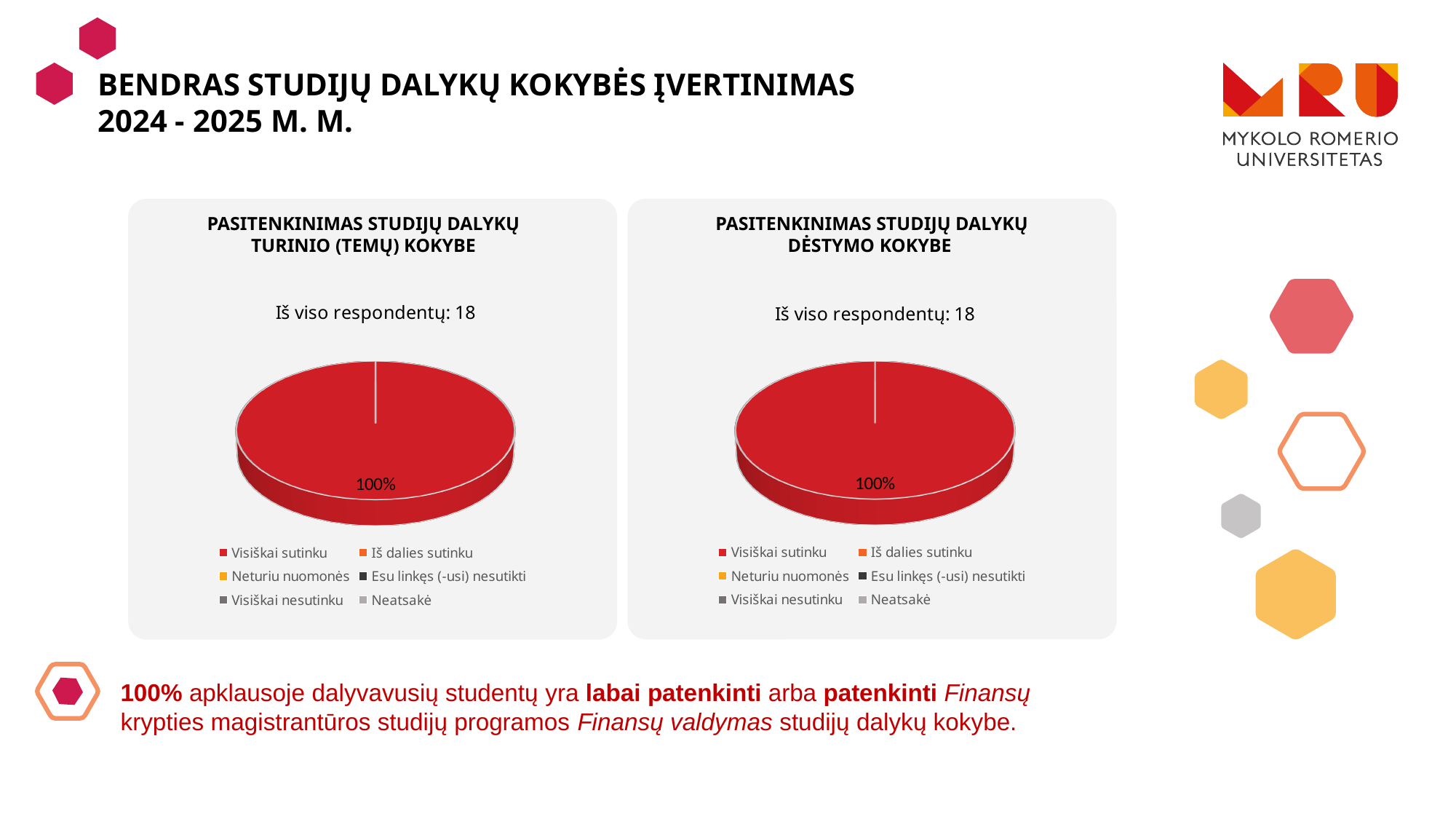
In the right chart (DĖSTYMO KOKYBE), which category has the largest share? Visiškai sutinku In the left chart (TURINIO (TEMŲ) KOKYBE), which legend category does the 100% slice correspond to? Visiškai sutinku In the right chart (DĖSTYMO KOKYBE), what share of the pie is labelled on the slice? 100% In the left chart (TURINIO (TEMŲ) KOKYBE), what share of the pie is labelled on the slice? 100% What colour is the single slice shown in the left chart (TURINIO (TEMŲ) KOKYBE)? Red How many respondents are reported for the left chart (TURINIO (TEMŲ) KOKYBE)? 18 In the right chart (DĖSTYMO KOKYBE), which legend category does the 100% slice correspond to? Visiškai sutinku What is the title of the right chart? PASITENKINIMAS STUDIJŲ DALYKŲ DĖSTYMO KOKYBE How many categories does the legend of the left chart (TURINIO (TEMŲ) KOKYBE) list? 6 What kind of chart is used in the left panel titled "PASITENKINIMAS STUDIJŲ DALYKŲ TURINIO (TEMŲ) KOKYBE"? Pie chart How many categories does the legend of the right chart (DĖSTYMO KOKYBE) list? 6 How many respondents are reported for the right chart (DĖSTYMO KOKYBE)? 18